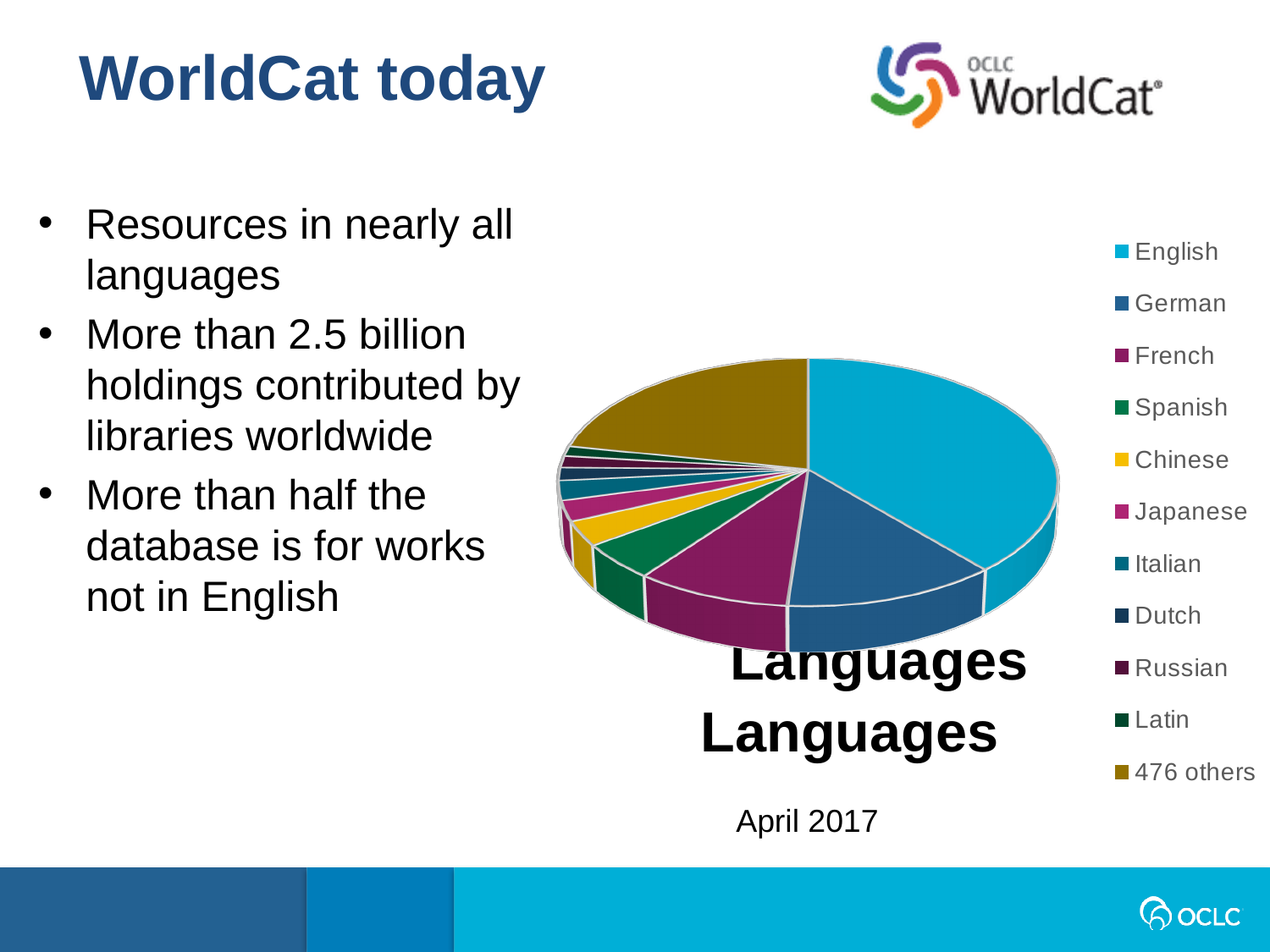
What is the title of the pie chart? Languages Which slice is larger in the pie chart, 476 others or French? 476 others Which slice is larger in the pie chart, English or 476 others? English Which slice is larger in the pie chart, Spanish or Latin? Spanish How many categories does the legend of the pie chart list? 11 What kind of chart is shown on the slide? pie chart Which language has the largest slice in the pie chart? English What is the last entry listed in the pie chart's legend? 476 others